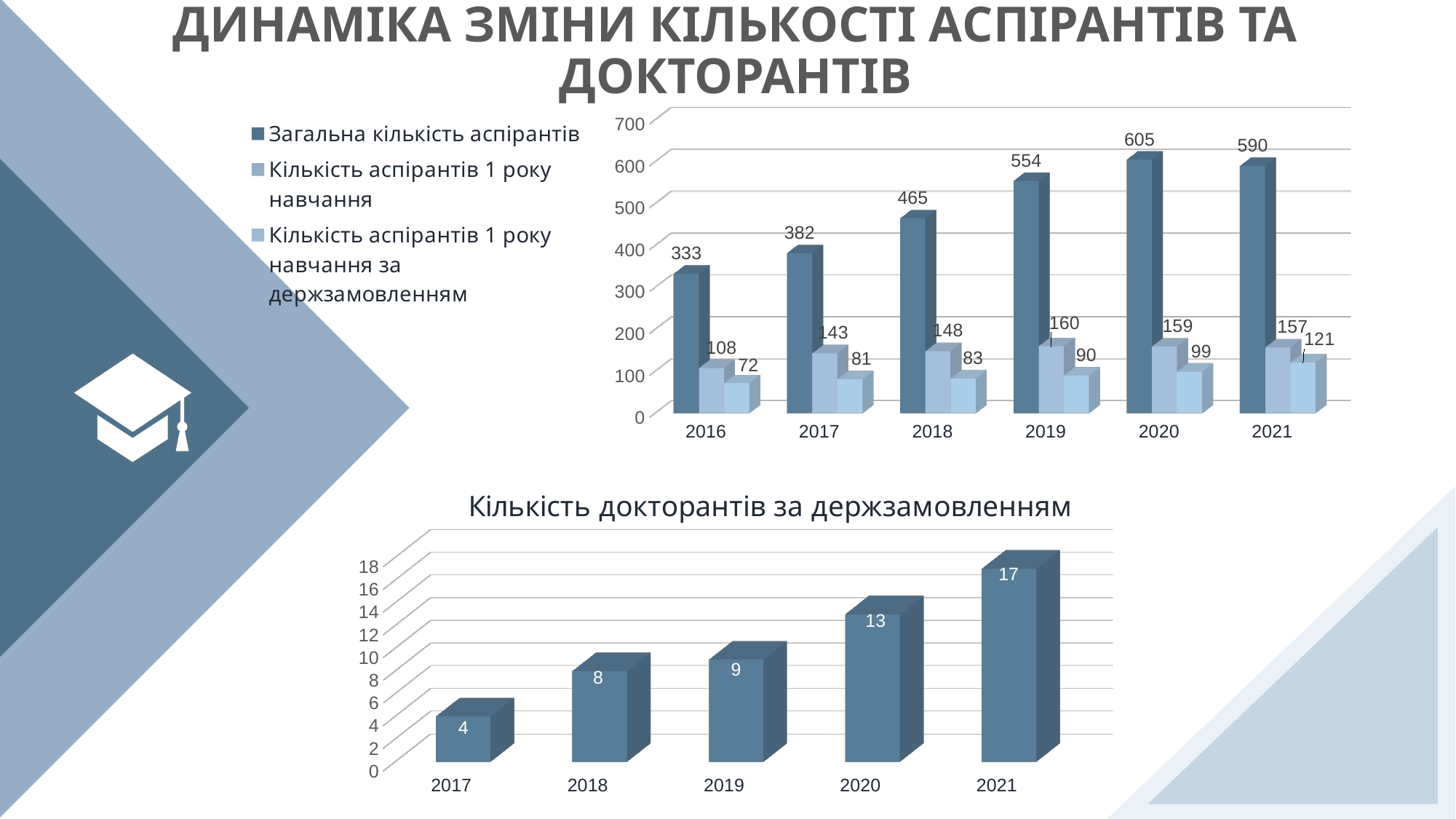
In the top chart, what is the difference between 'Загальна кількість аспірантів' in 2021 and in 2016? 257 In the top chart, what is the value of 'Кількість аспірантів 1 року навчання за держзамовленням' for 2021? 121 What kind of chart is 'Кількість докторантів за держзамовленням'? bar chart How many series does the legend of the top chart list? 3 In the chart 'Кількість докторантів за держзамовленням', what is the value for 2019? 9 In the top chart, which year has the lowest value for 'Кількість аспірантів 1 року навчання'? 2016 In the chart 'Кількість докторантів за держзамовленням', do the values rise or fall from 2017 to 2021? rise In the chart 'Кількість докторантів за держзамовленням', what is the difference between the values for 2021 and 2017? 13 In the top chart, is 'Кількість аспірантів 1 року навчання' larger in 2019 or in 2021? 2019 In the top chart, which year has the highest value for 'Загальна кількість аспірантів'? 2020 In the top chart, what is the value of 'Загальна кількість аспірантів' for 2020? 605 How many years are shown on the x axis of the top chart? 6